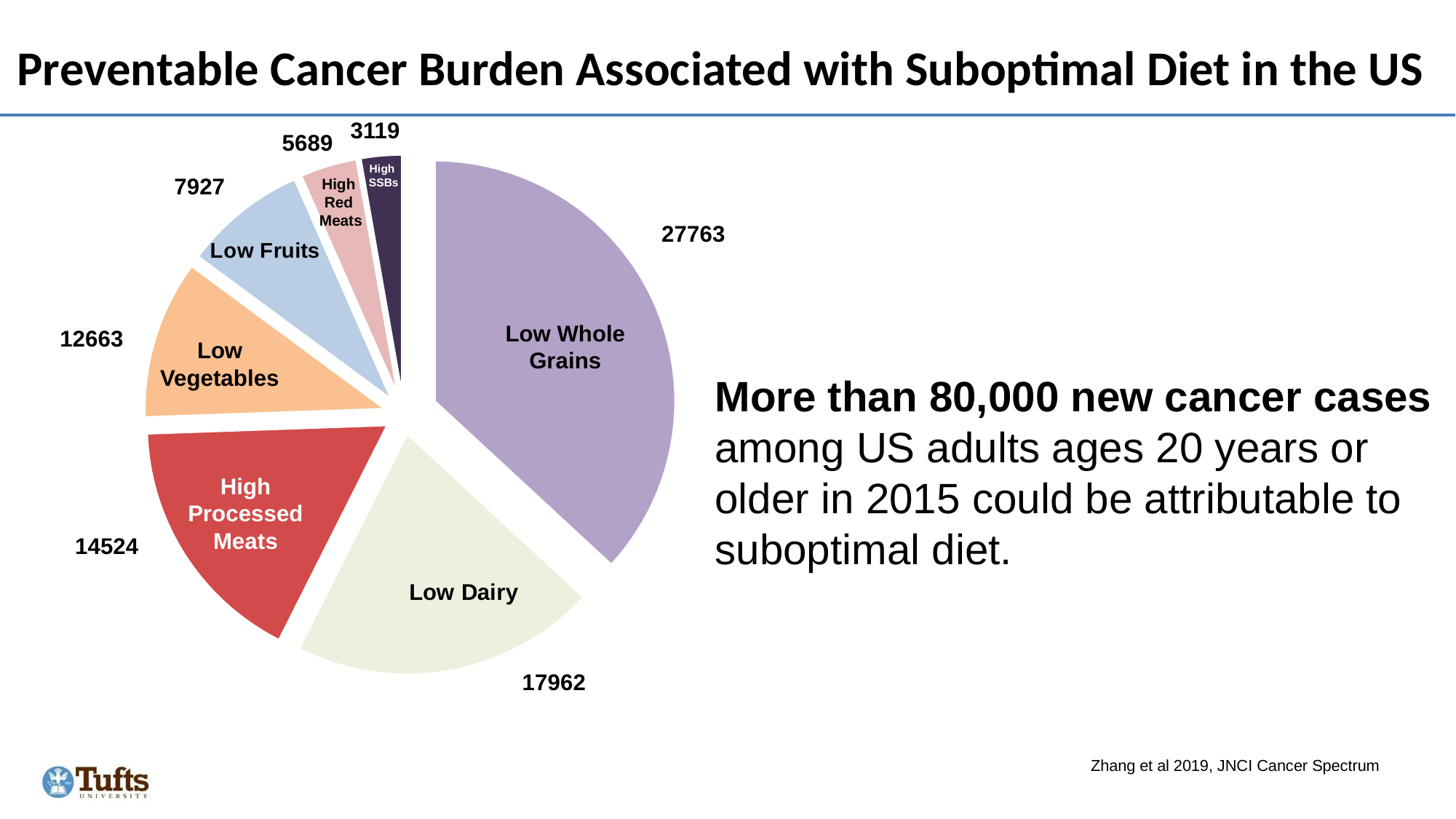
Which is larger, the value for Low Vegetables or the value for Low Fruits? Low Vegetables How many slices does the pie chart have? 7 What is the difference between the values for Low Whole Grains and Low Dairy? 9801 What is the value for Low Dairy? 17962 What is the value for Low Whole Grains? 27763 Which category has the largest slice of the pie? Low Whole Grains What is the value for High SSBs? 3119 What is the difference between the values for Low Fruits and High Red Meats? 2238 What is the value for High Processed Meats? 14524 What is the title of the slide containing the pie chart? Preventable Cancer Burden Associated with Suboptimal Diet in the US What type of chart is shown on the slide? Pie chart Which category has the smallest slice of the pie? High SSBs